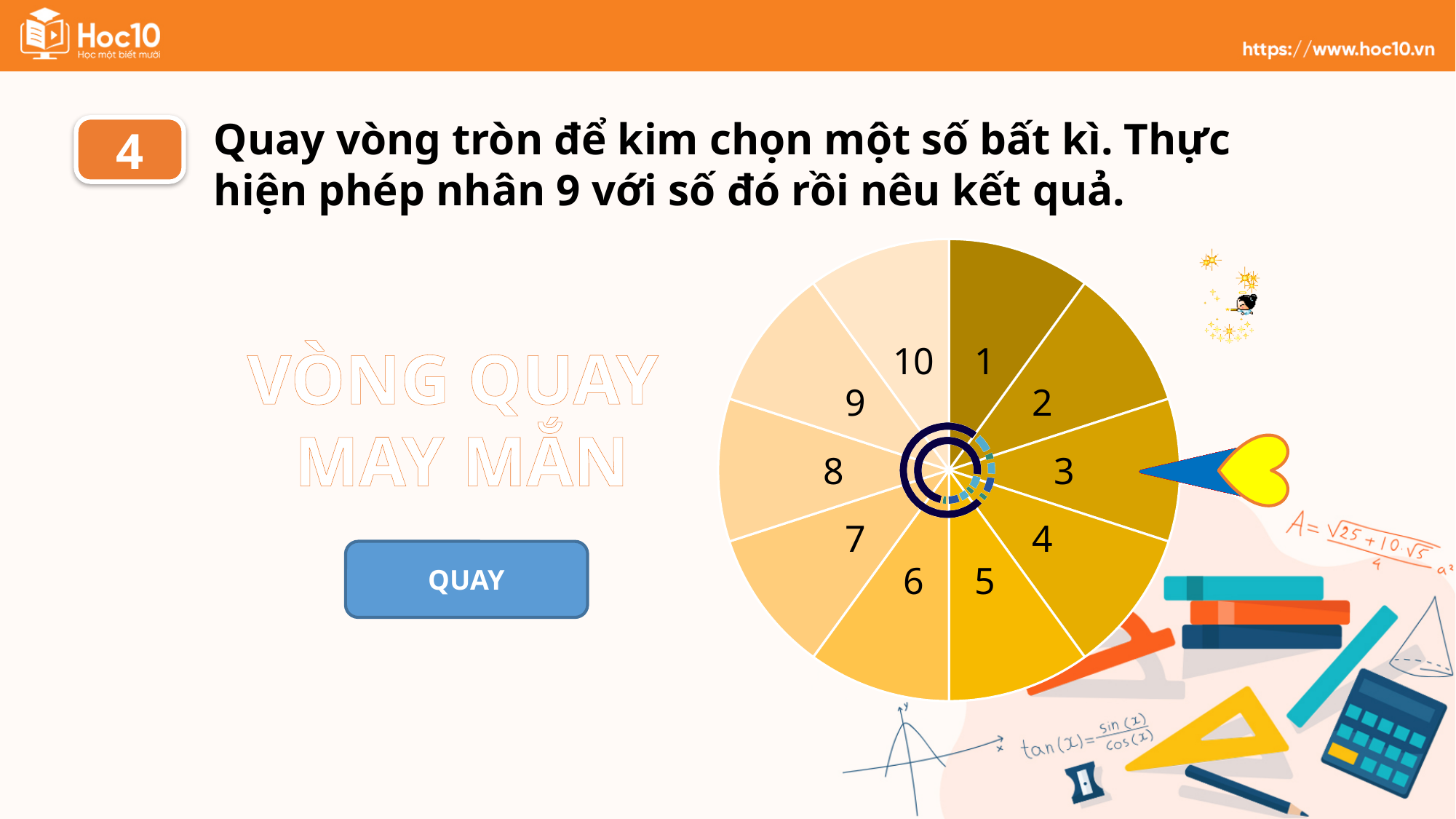
Which number on the wheel does the arrow point to? 3 What is the title shown to the left of the wheel? VÒNG QUAY MAY MẮN What is the smallest number printed on the wheel? 1 How many numbered slices does the wheel have? 10 What is the largest number printed on the wheel? 10 What kind of chart is the wheel on the slide? pie chart What text is on the blue button below the title? QUAY Which slice label is directly to the right of the slice labelled 10 at the top of the wheel? 1 Which slice label sits between 4 and 6 on the wheel? 5